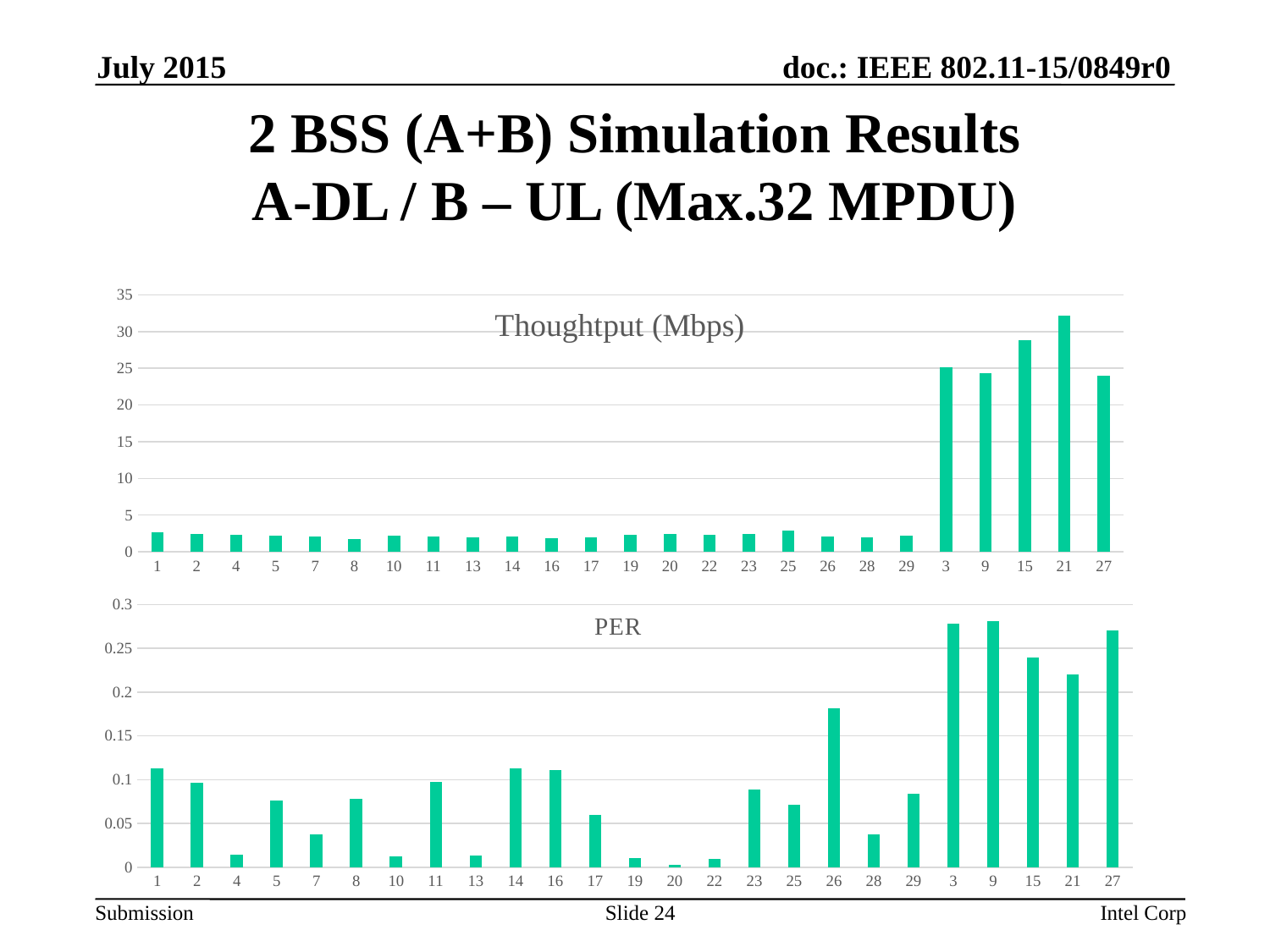
In the Thoughtput (Mbps) chart, is the value for category 15 greater or less than 25? greater How many categories are plotted in the PER chart? 25 In the PER chart, is the value for category 26 greater or less than 0.15? greater In the Thoughtput (Mbps) chart, is the value for category 21 greater or less than 30? greater In the PER chart, which category has the lowest value? 20 What kind of chart is the Thoughtput (Mbps) chart? bar chart What is the title of the lower chart on the slide? PER In the PER chart, which is larger, the value for category 26 or category 25? 26 In the Thoughtput (Mbps) chart, which category has the highest value? 21 In the Thoughtput (Mbps) chart, which is larger, the value for category 21 or category 27? 21